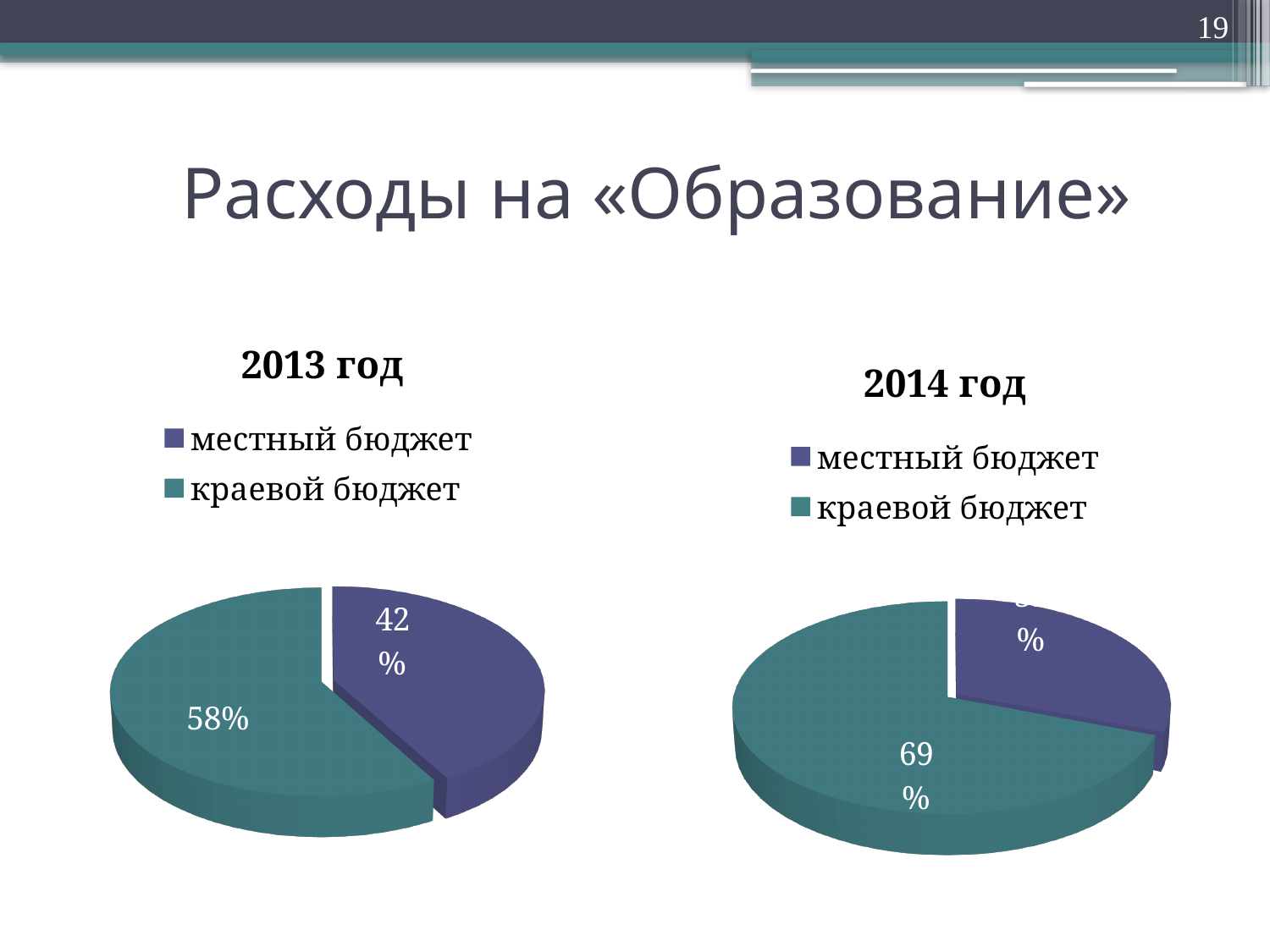
How many categories does the legend of the "2013 год" chart list? 2 In the "2013 год" pie chart, which is larger: местный бюджет or краевой бюджет? краевой бюджет In the "2013 год" pie chart, what is the difference in percentage points between краевой бюджет and местный бюджет? 16 percentage points In the "2013 год" pie chart, which category has the smallest slice? местный бюджет What is the title of the slide? Расходы на «Образование» What type of chart is used for "2014 год"? Pie chart In the "2013 год" pie chart, what percentage is shown for краевой бюджет? 58% In the "2013 год" pie chart, which category has the largest slice? краевой бюджет In the "2014 год" pie chart, what percentage is shown for краевой бюджет? 69% In the "2013 год" pie chart, what percentage is shown for местный бюджет? 42% In the "2014 год" pie chart, which category has the largest slice? краевой бюджет In the "2014 год" pie chart, what colour is the краевой бюджет slice? Teal